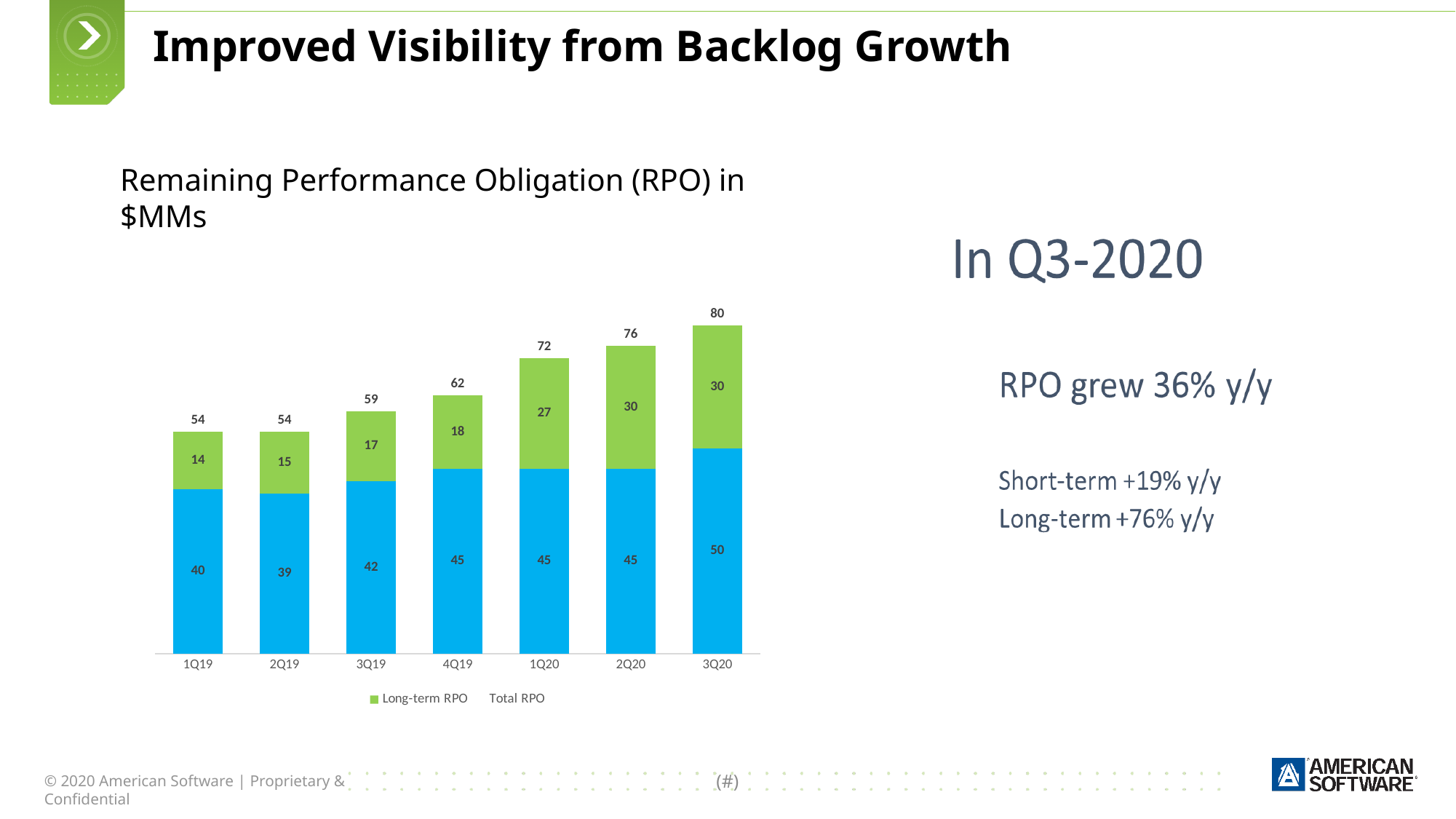
What is the difference between the total RPO for 3Q20 and 3Q19? 21 How many entries does the legend list? 2 What is the total RPO value labeled above the 3Q20 bar? 80 What is the Long-term RPO value (green segment) for 1Q20? 27 Which quarter has the lowest Long-term RPO (green segment)? 1Q19 What kind of chart is shown on the slide? Stacked bar chart How many quarters are shown on the x axis? 7 Does the total RPO generally rise or fall from 1Q19 to 3Q20? Rise Which quarter has the highest total RPO? 3Q20 What is the value of the blue (bottom) segment for 4Q19? 45 What is the title of the chart? Remaining Performance Obligation (RPO) in $MMs Is the Long-term RPO (green segment) larger in 2Q20 or in 4Q19? 2Q20